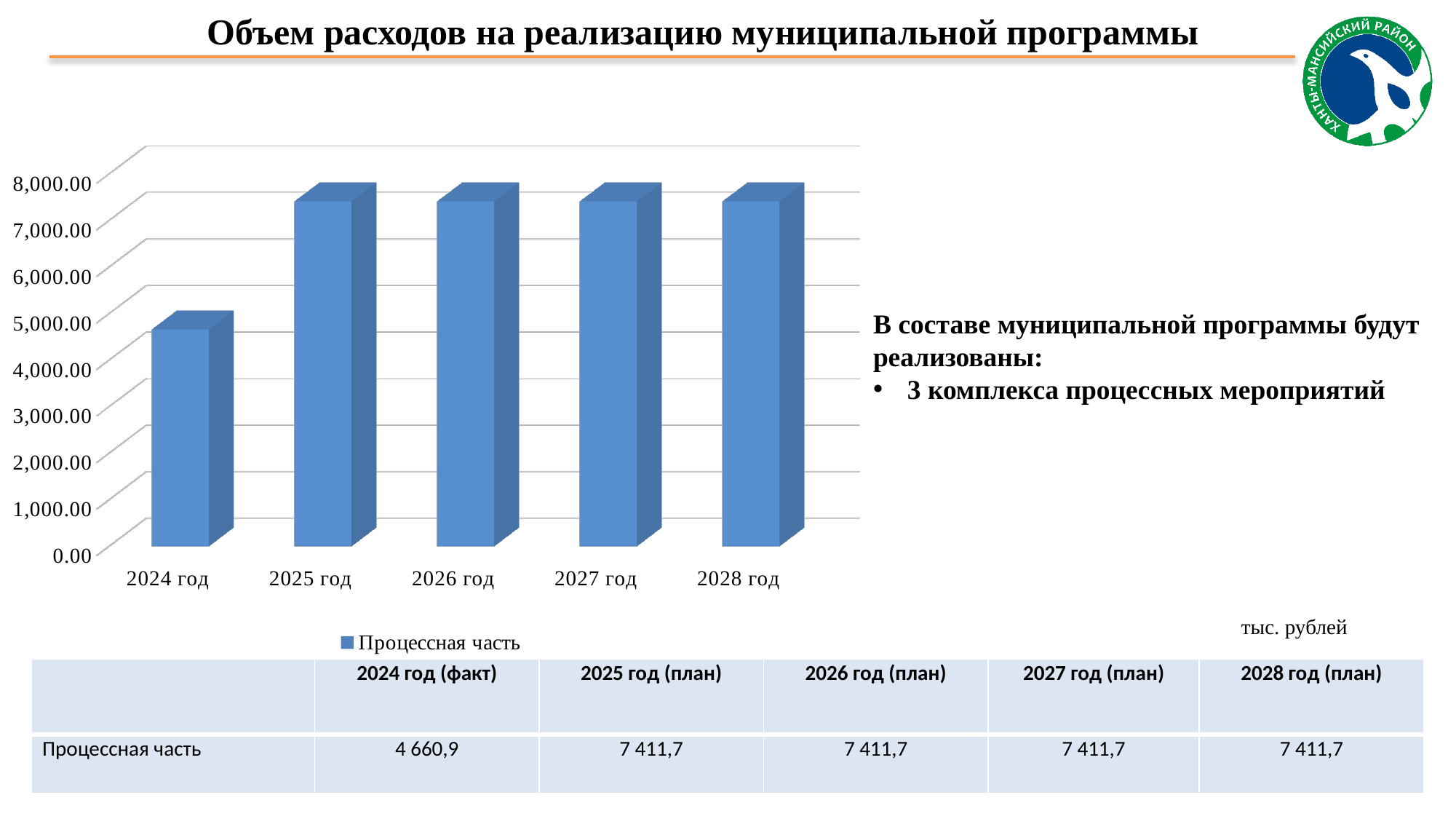
What is the value for 2024 год according to the table below the chart? 4 660,9 What is the name of the series shown in the chart legend? Процессная часть Which year has the lowest value in the chart? 2024 год Is the value for 2024 год greater or less than 5,000.00? less What is the title of the chart on the slide? Объем расходов на реализацию муниципальной программы Is the value for 2026 год greater or less than 7,000.00? greater How many series does the chart legend list? 1 What is the value for 2025 год according to the table below the chart? 7 411,7 Which is larger, the value for 2024 год or the value for 2025 год? 2025 год What kind of chart is shown on the slide? bar chart How many categories (years) are shown on the x axis of the chart? 5 What is the value for 2028 год according to the table below the chart? 7 411,7